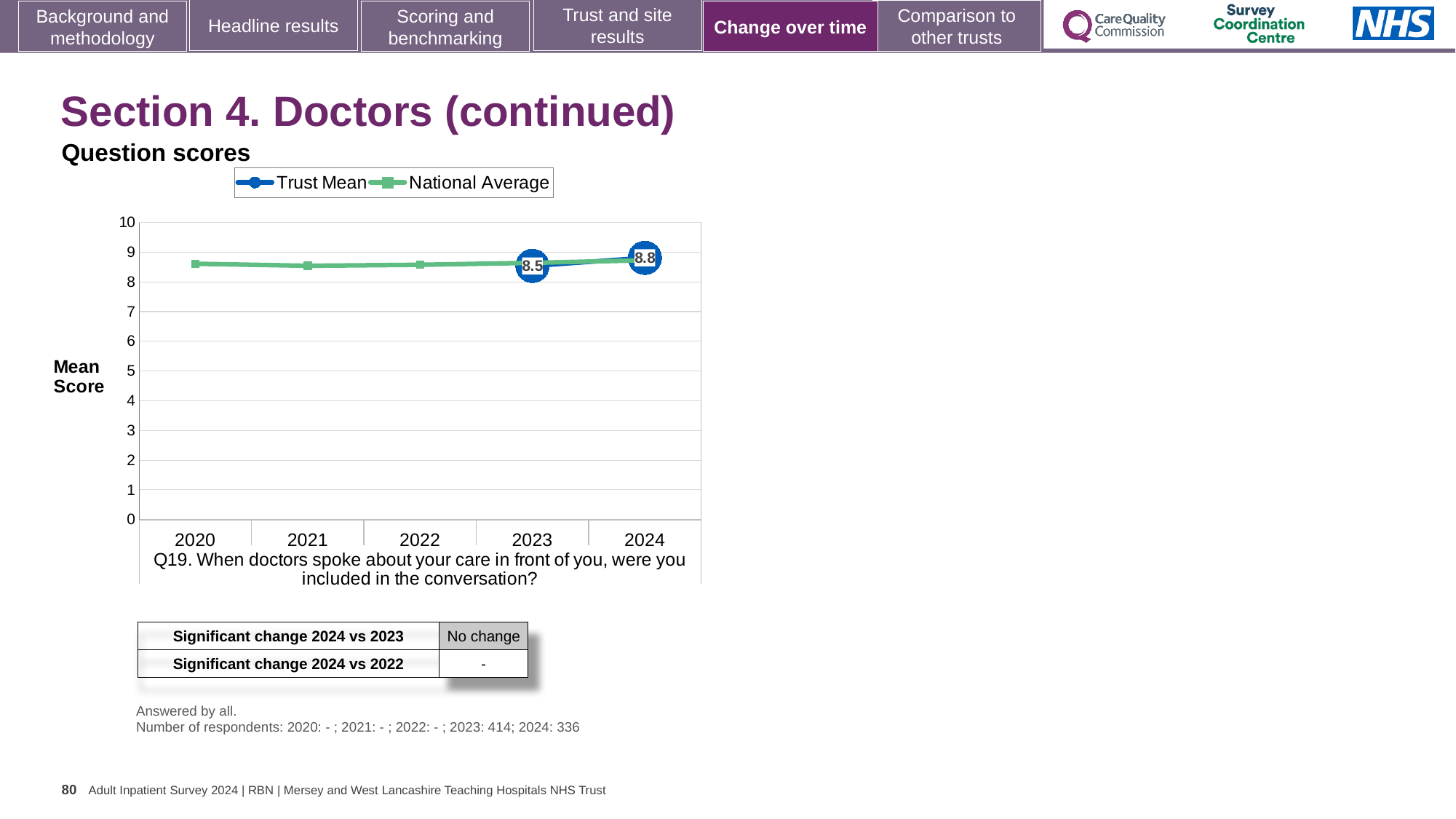
Does the Trust Mean rise or fall from 2023 to 2024? rise Which question does the chart relate to? Q19. When doctors spoke about your care in front of you, were you included in the conversation? What is the Trust Mean score for 2024? 8.8 Is the National Average value for 2022 greater or less than 9? less How many series does the chart legend list? 2 How many years are shown on the x axis of the chart? 5 Which year has the higher Trust Mean score, 2023 or 2024? 2024 Is the National Average value for 2020 greater or less than 8? greater What is the difference between the Trust Mean scores for 2024 and 2023? 0.3 What is the Trust Mean score for 2023? 8.5 What kind of chart is shown on the slide? line chart What is the label of the y axis of the chart? Mean Score